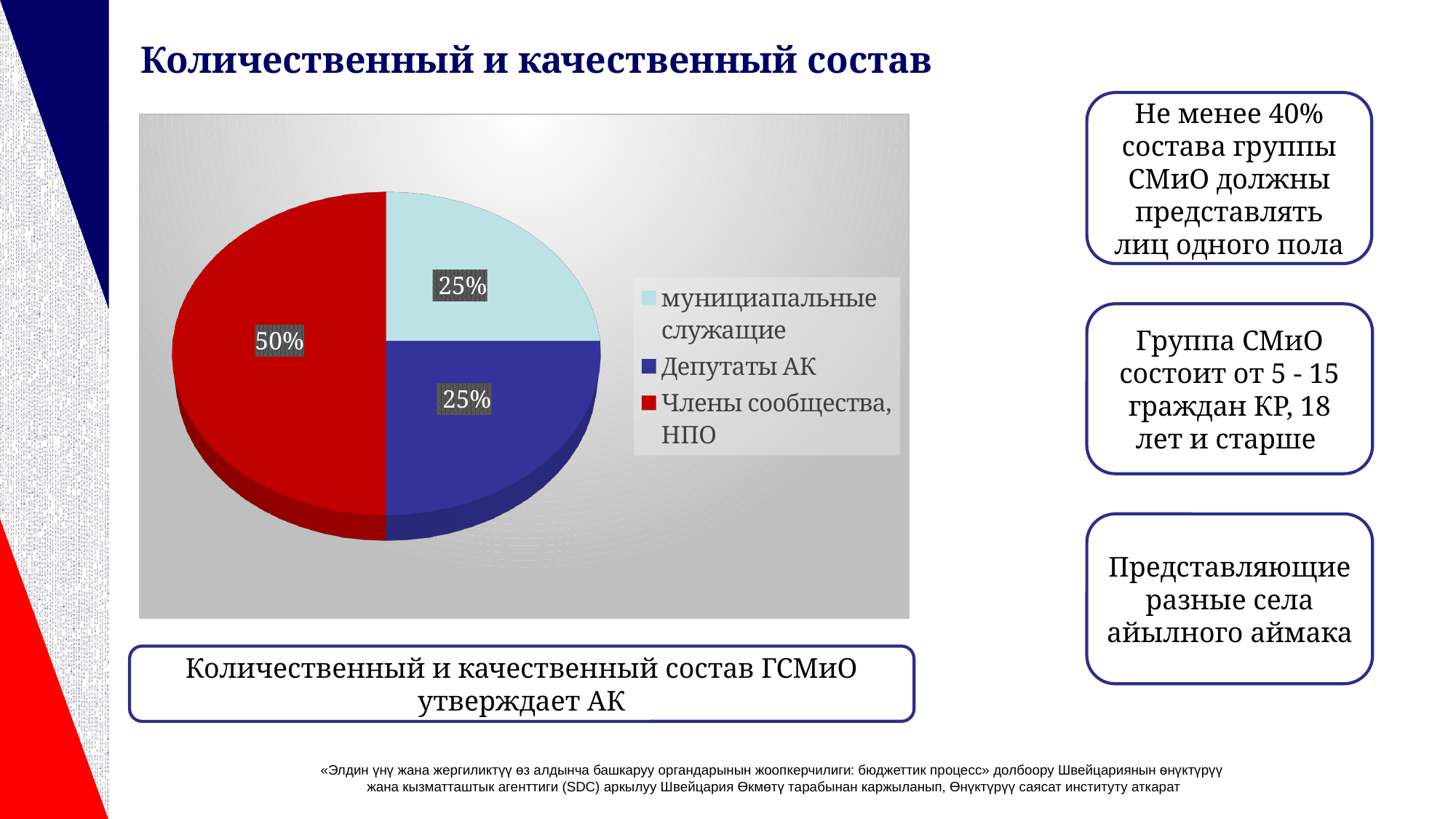
What kind of chart is shown on the slide? pie chart What colour is the slice for Члены сообщества, НПО? red How many entries does the legend list? 3 What is the combined share of мунициапальные служащие and Депутаты АК? 50% Which category has the largest slice of the pie? Члены сообщества, НПО What share of the pie does the slice for Депутаты АК represent? 25% Which is larger: the share for Члены сообщества, НПО or the share for мунициапальные служащие? Члены сообщества, НПО How many slices does the pie chart have? 3 What is the difference between the share for Члены сообщества, НПО and the share for Депутаты АК? 25% What share of the pie does the slice for Члены сообщества, НПО represent? 50% What share of the pie does the slice for мунициапальные служащие represent? 25% What colour is the slice for Депутаты АК? blue